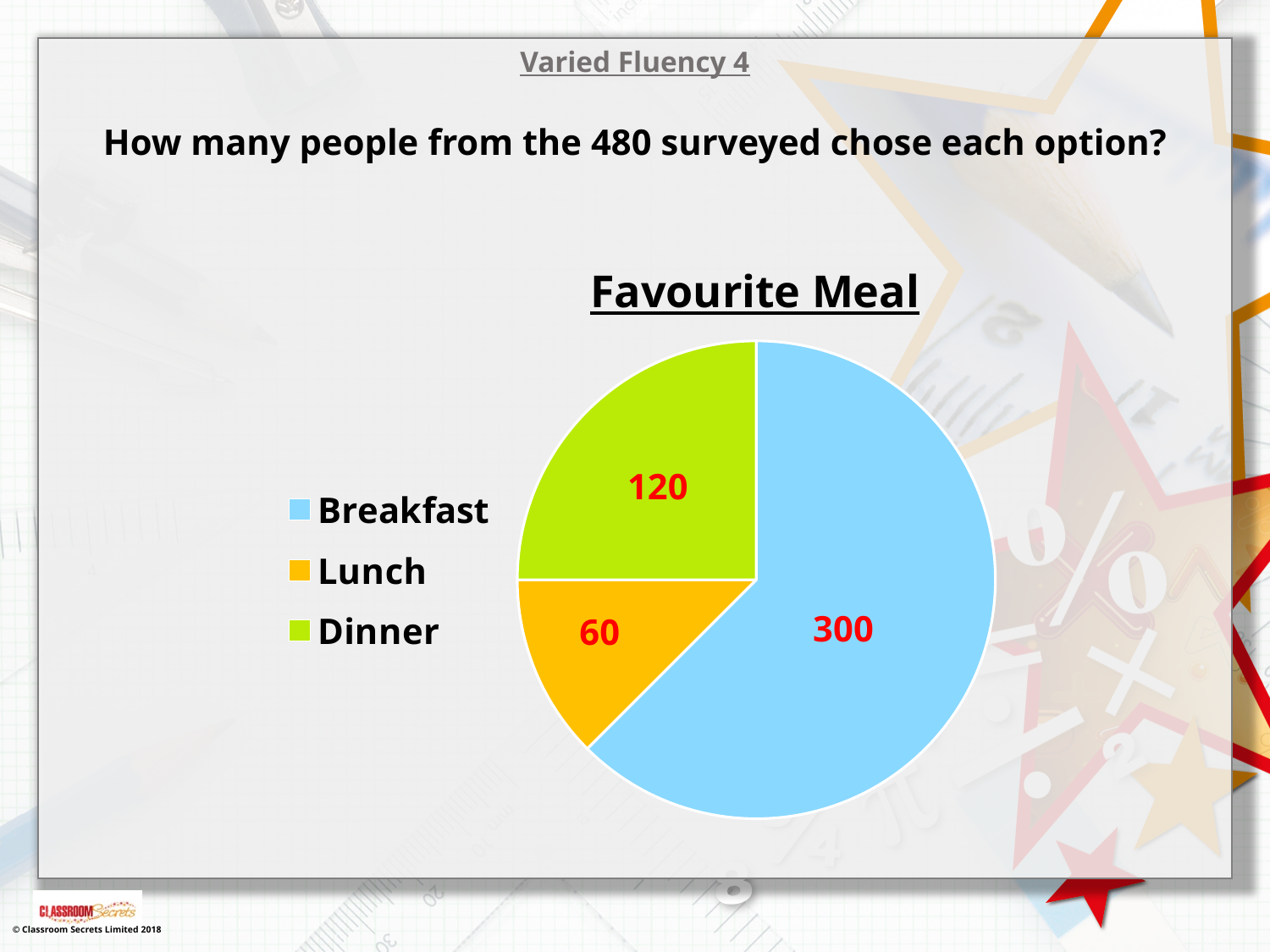
How many more people chose Breakfast than Dinner? 180 How many people chose Dinner? 120 Which meal was chosen by the most people? Breakfast How many categories does the pie chart show? 3 Which meal was chosen by the fewest people? Lunch What type of chart is shown on the slide? pie chart Which was chosen by more people, Lunch or Dinner? Dinner How many people chose Breakfast? 300 What share of the total does the Lunch slice represent? 12.5% What is the title of the chart? Favourite Meal How many more people chose Dinner than Lunch? 60 How many people chose Lunch? 60